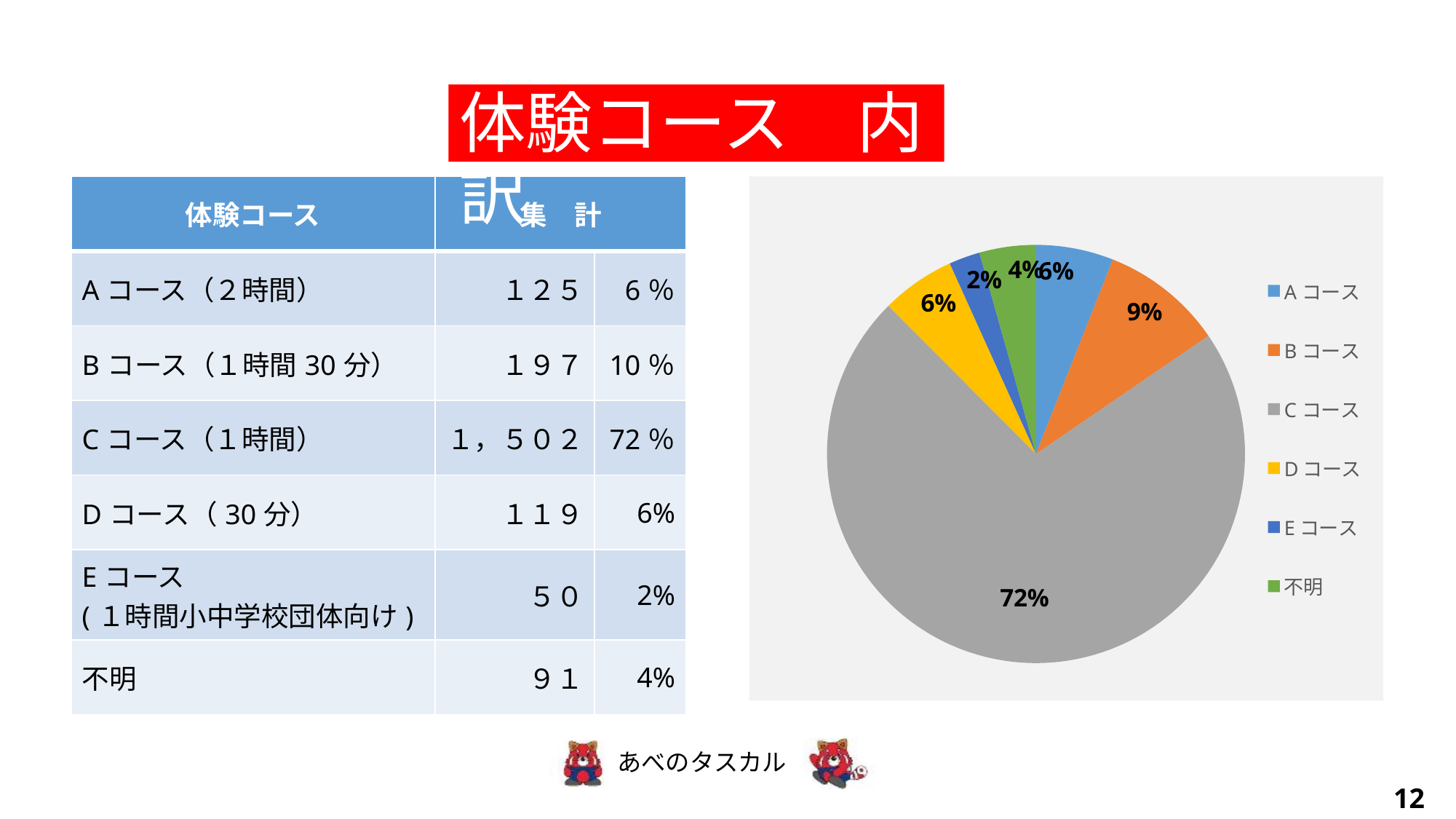
In the pie chart, what is the difference in percentage points between 不明 and E コース? 2 How many categories does the pie chart's legend list? 6 What percentage does the pie chart show for B コース? 9% Which category has the largest slice in the pie chart? C コース What percentage does the pie chart show for 不明? 4% What percentage does the pie chart show for C コース? 72% What percentage does the pie chart show for E コース? 2% What kind of chart is shown on the slide? pie chart What colour is the C コース slice in the pie chart? gray In the pie chart, what is the difference in percentage points between C コース and B コース? 63 In the pie chart, which slice is larger, B コース or D コース? B コース Which category has the smallest slice in the pie chart? E コース